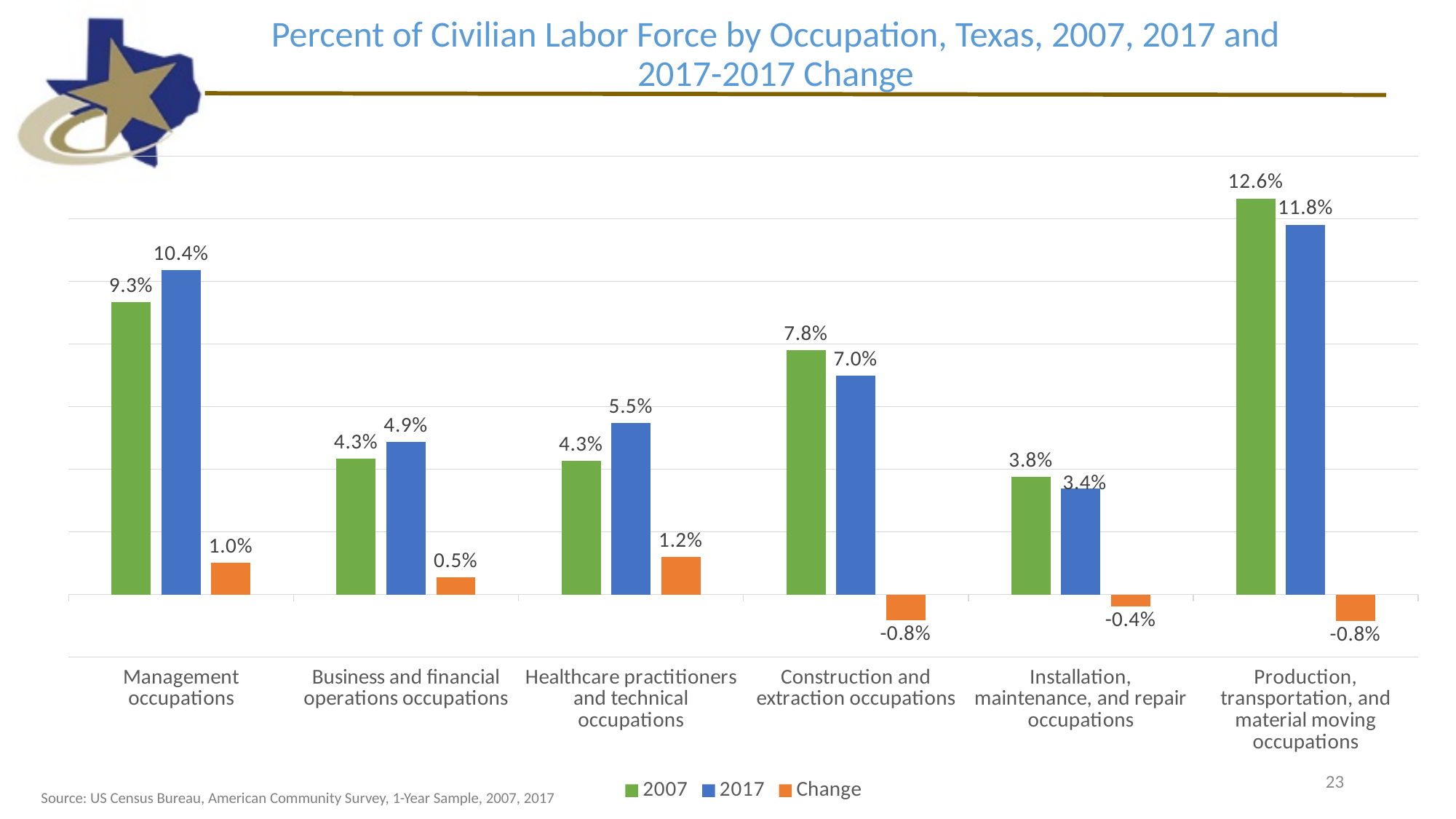
Which occupation category has the highest 2017 value? Production, transportation, and material moving occupations What was the 2017 value for Management occupations? 10.4% Which is larger for Construction and extraction occupations, the 2007 value or the 2017 value? 2007 What was the 2007 value for Construction and extraction occupations? 7.8% How many occupation categories are shown on the chart? 6 What is the Change value for Installation, maintenance, and repair occupations? -0.4% What is the Change value for Healthcare practitioners and technical occupations? 1.2% How many series does the legend list? 3 What is the difference between the 2017 and 2007 values for Healthcare practitioners and technical occupations? 1.2% Which colour represents the Change series in the legend? Orange What kind of chart is shown on the slide? Bar chart Which occupation category has the lowest 2017 value? Installation, maintenance, and repair occupations